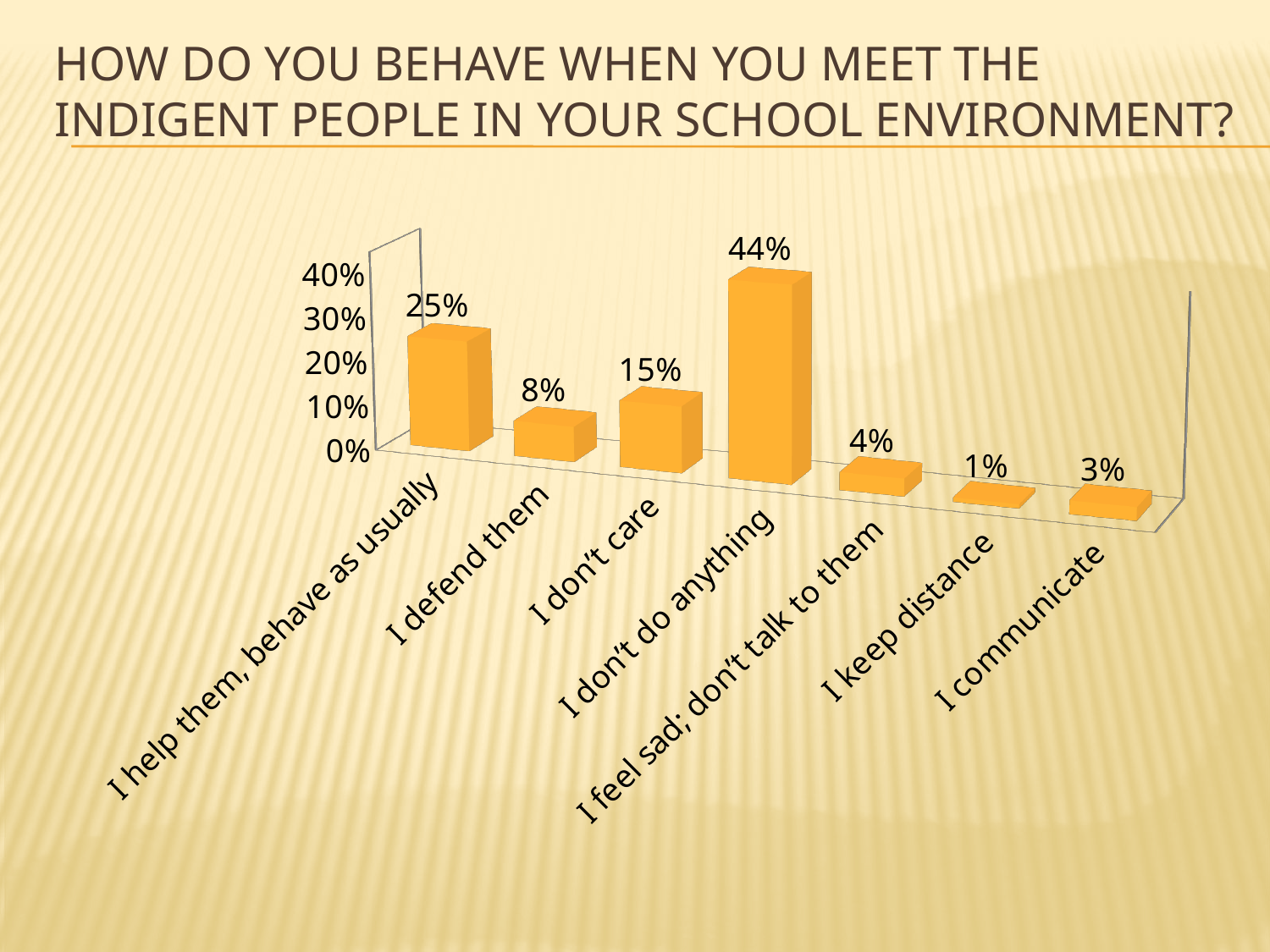
Which response has the lowest percentage? I keep distance What is the value for "I feel sad; don't talk to them"? 4% What is the difference between "I don't care" and "I defend them"? 7% What type of chart is shown on the slide? Bar chart What is the highest value shown on the vertical axis? 40% Which is larger, "I communicate" or "I feel sad; don't talk to them"? I feel sad; don't talk to them What is the difference between "I don't do anything" and "I help them, behave as usually"? 19% Which response has the highest percentage? I don't do anything How many response categories are shown in the chart? 7 What percentage chose "I keep distance"? 1% What is the value for "I help them, behave as usually"? 25% What percentage of respondents said "I don't do anything"? 44%